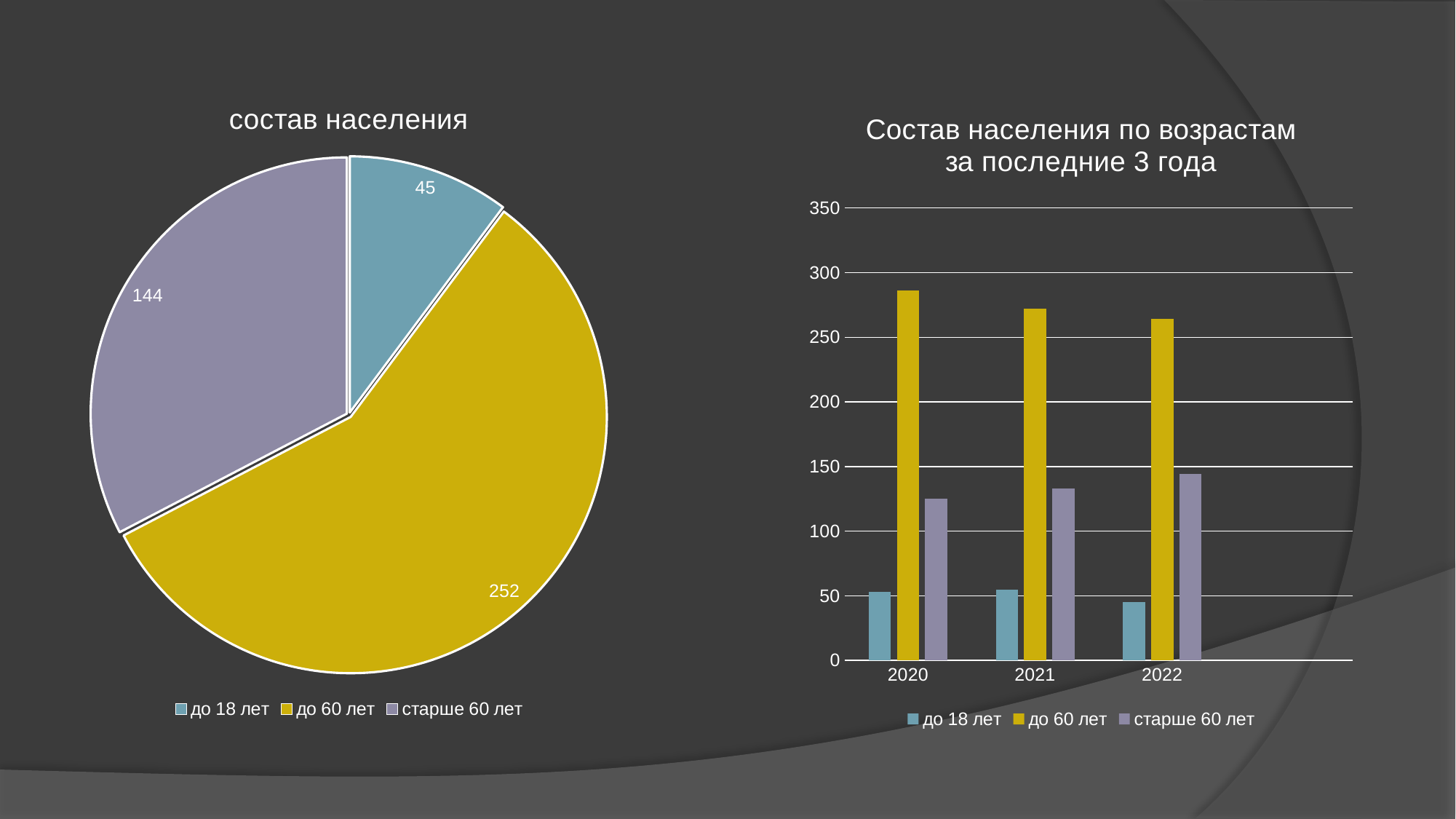
On the pie chart "состав населения", what is the value for "старше 60 лет"? 144 On the pie chart "состав населения", which category has the smallest value? до 18 лет On the pie chart "состав населения", what is the total of all three slices? 441 What kind of chart is the chart on the left of the slide? Pie chart On the chart "Состав населения по возрастам за последние 3 года", how many years are shown on the x axis? 3 On the chart "Состав населения по возрастам за последние 3 года", is the value for "до 60 лет" in 2020 greater or less than 250? greater On the pie chart "состав населения", which category has the largest value? до 60 лет On the pie chart "состав населения", what is the value for "до 60 лет"? 252 On the chart "Состав населения по возрастам за последние 3 года", how many series does the legend list? 3 What kind of chart is "Состав населения по возрастам за последние 3 года"? Bar chart On the chart "Состав населения по возрастам за последние 3 года", do the values for "до 60 лет" rise or fall from 2020 to 2022? fall On the pie chart "состав населения", what is the difference between the values for "до 60 лет" and "старше 60 лет"? 108